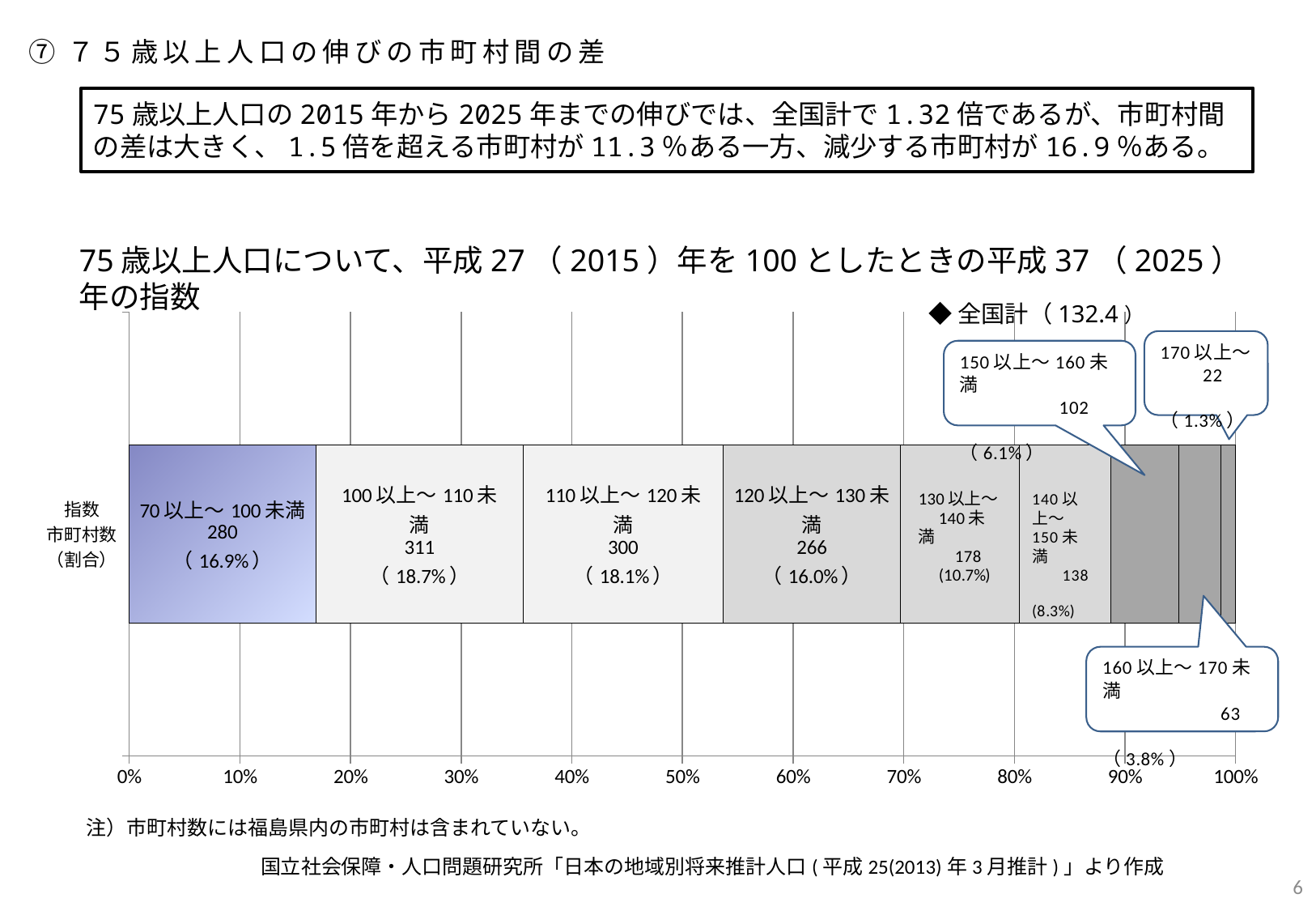
Which index category has the largest number of municipalities? 100以上～110未満 What is the total number of municipalities across all segments of the bar? 1660 What share of municipalities is in the 100以上～110未満 category? 18.7% How many municipalities fall in the 70以上～100未満 category? 280 Which has more municipalities, the 130以上～140未満 category or the 140以上～150未満 category? 130以上～140未満 How many index categories are shown in the stacked bar? 9 What is the difference in the number of municipalities between the 110以上～120未満 and 120以上～130未満 categories? 34 How many municipalities are in the 160以上～170未満 category? 63 What kind of chart is shown on the slide? bar chart Which index category has the smallest number of municipalities? 170以上～ What national total index value (全国計) is shown above the chart? 132.4 What percentage is shown for the 170以上～ category? 1.3%